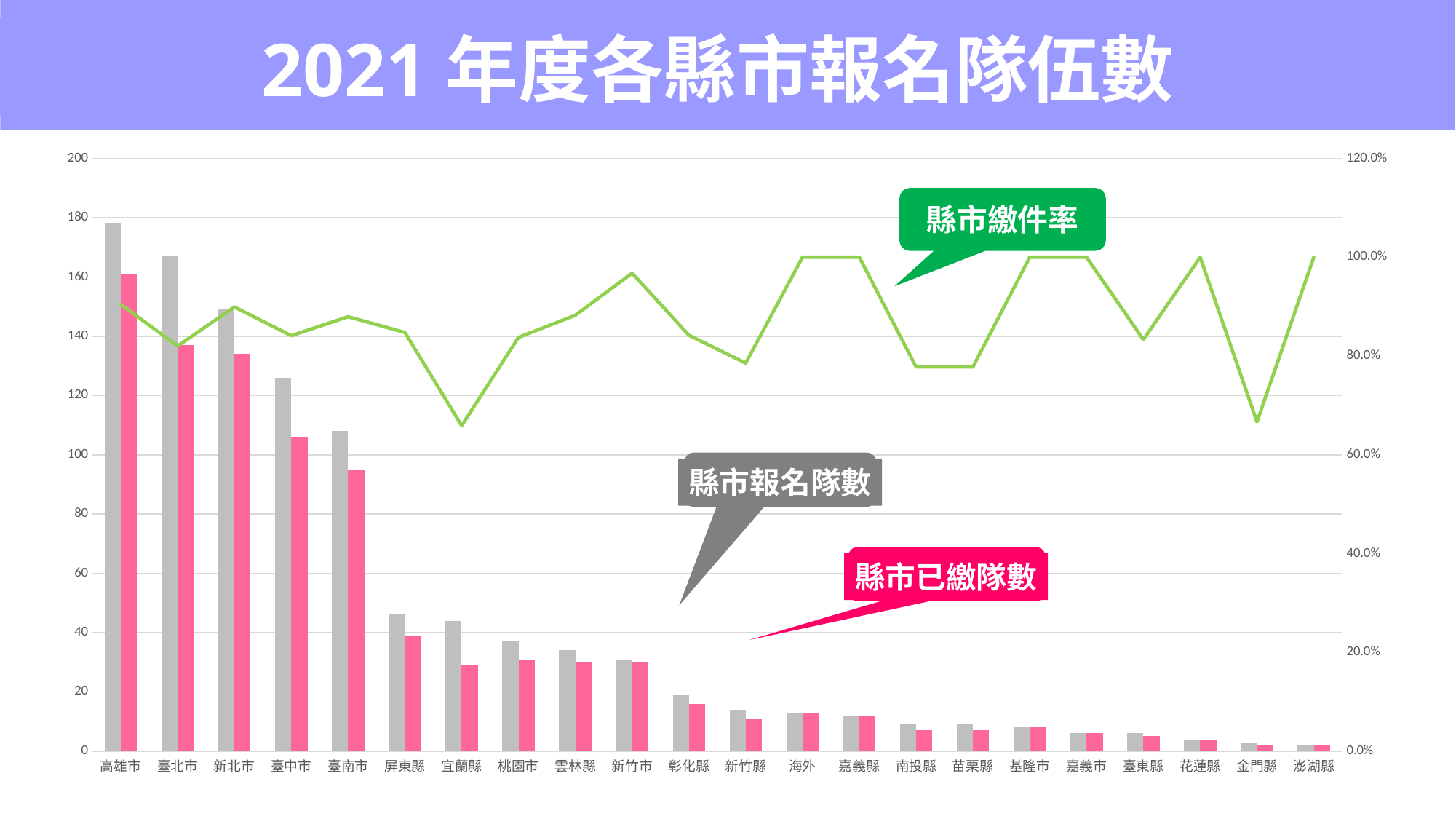
Is the 縣市已繳隊數 value for 宜蘭縣 greater or less than 40? less Is the 縣市繳件率 for 宜蘭縣 greater or less than 80.0%? less Do the 縣市報名隊數 bars generally rise or fall from left to right along the x axis? fall Is the 縣市已繳隊數 value for 臺北市 greater or less than 120? greater Which is larger, the 縣市報名隊數 for 臺北市 or for 新北市? 臺北市 Which category has the highest 縣市報名隊數 (grey bar)? 高雄市 What kind of chart is shown on the slide? A combined bar and line chart How many counties/cities (categories) are shown on the x axis? 22 What colour is the line representing 縣市繳件率? Green How many data series are labelled on the chart? 3